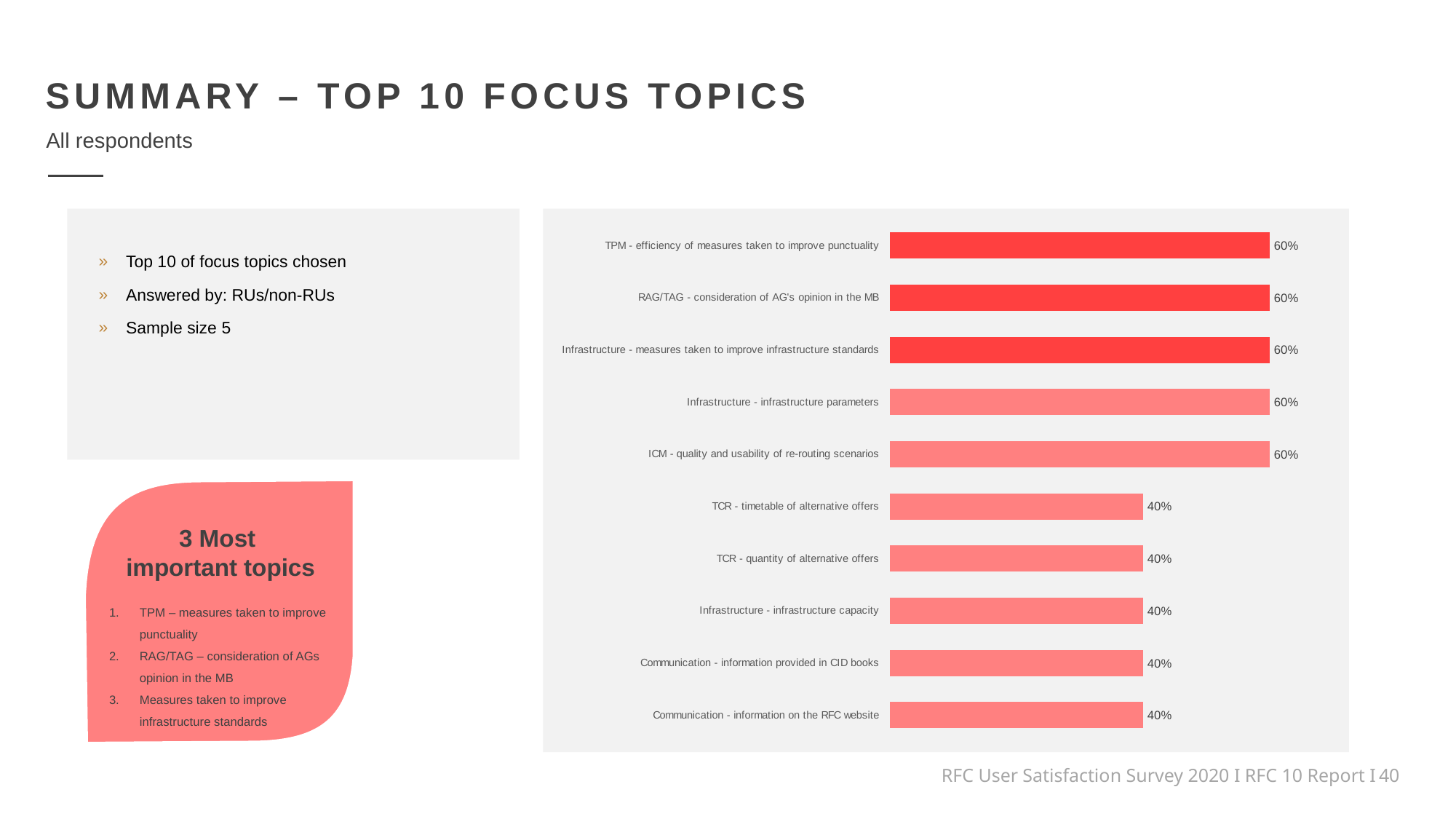
What is the value for "ICM - quality and usability of re-routing scenarios"? 60% How many categories are shown in the chart? 10 How many categories have a value of 40%? 5 What is the value for "TPM - efficiency of measures taken to improve punctuality"? 60% What kind of chart is shown on the slide? Bar chart How many categories have a value of 60%? 5 What is the value for "Communication - information on the RFC website"? 40% Which is larger: the value for "RAG/TAG - consideration of AG's opinion in the MB" or the value for "TCR - quantity of alternative offers"? RAG/TAG - consideration of AG's opinion in the MB Which category is listed at the top of the chart? TPM - efficiency of measures taken to improve punctuality What is the value for "Communication - information provided in CID books"? 40% What is the value for "TCR - timetable of alternative offers"? 40% What is the difference between the value for "Infrastructure - infrastructure parameters" and the value for "Infrastructure - infrastructure capacity"? 20%